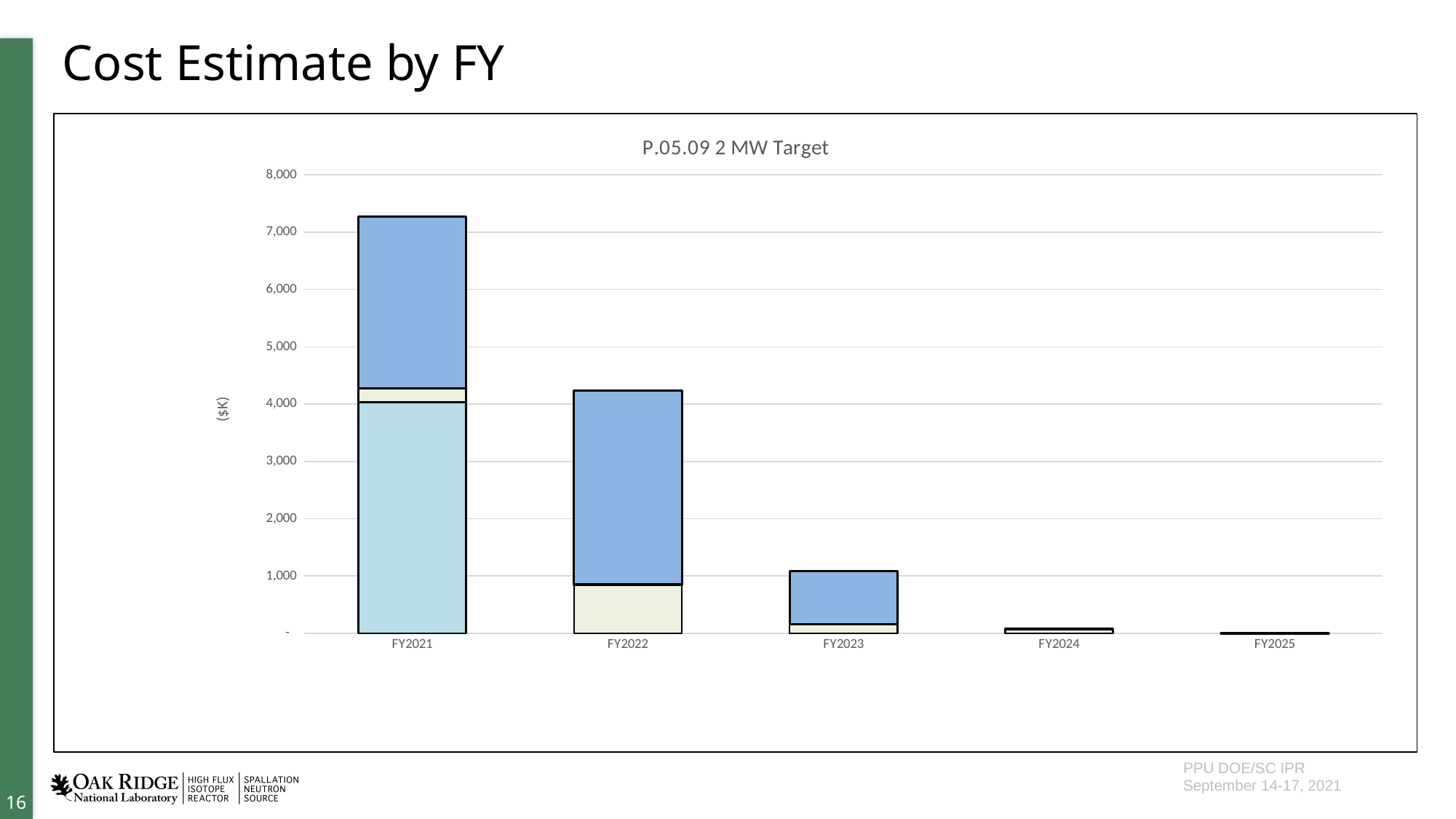
What is the label on the vertical axis of the chart? ($K) Which bar is taller, FY2021 or FY2022? FY2021 Which fiscal year has the tallest bar in the chart? FY2021 Is the total bar height for FY2021 greater or less than 7,000? greater Which fiscal year has the shortest bar in the chart? FY2025 Is the total bar height for FY2023 greater or less than 2,000? less Do the bar totals rise or fall from FY2021 to FY2025? fall Is the total bar height for FY2022 greater or less than 5,000? less How many fiscal years are shown on the x axis of the chart? 5 What kind of chart is shown on the slide? Stacked bar chart What is the title of the chart? P.05.09 2 MW Target